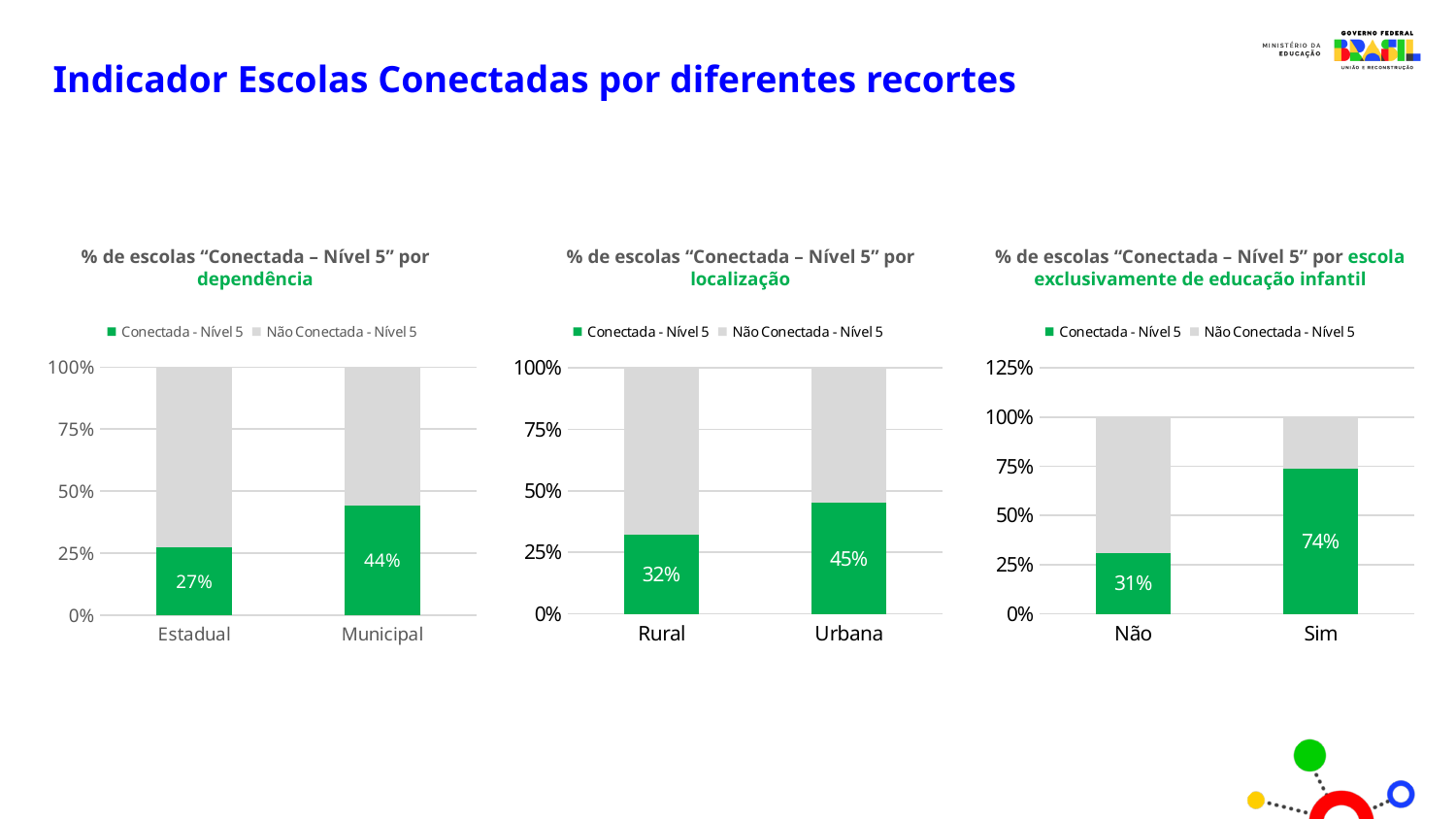
In the chart "% de escolas “Conectada – Nível 5” por localização", which category has the higher Conectada - Nível 5 value, Rural or Urbana? Urbana In the chart "% de escolas “Conectada – Nível 5” por dependência", what is the difference between the Conectada - Nível 5 values for Municipal and Estadual? 17% In the chart "% de escolas “Conectada – Nível 5” por dependência", is the Não Conectada - Nível 5 value for Estadual greater or less than 50%? greater In the chart "% de escolas “Conectada – Nível 5” por localização", what is the Conectada - Nível 5 value for Urbana? 45% In the chart "% de escolas “Conectada – Nível 5” por dependência", what is the value for Conectada - Nível 5 for Municipal? 44% What type of chart is the chart "% de escolas “Conectada – Nível 5” por escola exclusivamente de educação infantil"? Stacked bar chart In the chart "% de escolas “Conectada – Nível 5” por escola exclusivamente de educação infantil", what is the Conectada - Nível 5 value for Sim? 74% In the chart "% de escolas “Conectada – Nível 5” por escola exclusivamente de educação infantil", what is the Conectada - Nível 5 value for Não? 31% In the chart "% de escolas “Conectada – Nível 5” por localização", what is the Conectada - Nível 5 value for Rural? 32% In the chart "% de escolas “Conectada – Nível 5” por escola exclusivamente de educação infantil", is the Não Conectada - Nível 5 value for Sim greater or less than 50%? less How many series does the legend list in the chart "% de escolas “Conectada – Nível 5” por localização"? 2 In the chart "% de escolas “Conectada – Nível 5” por dependência", what is the value for Conectada - Nível 5 for Estadual? 27%